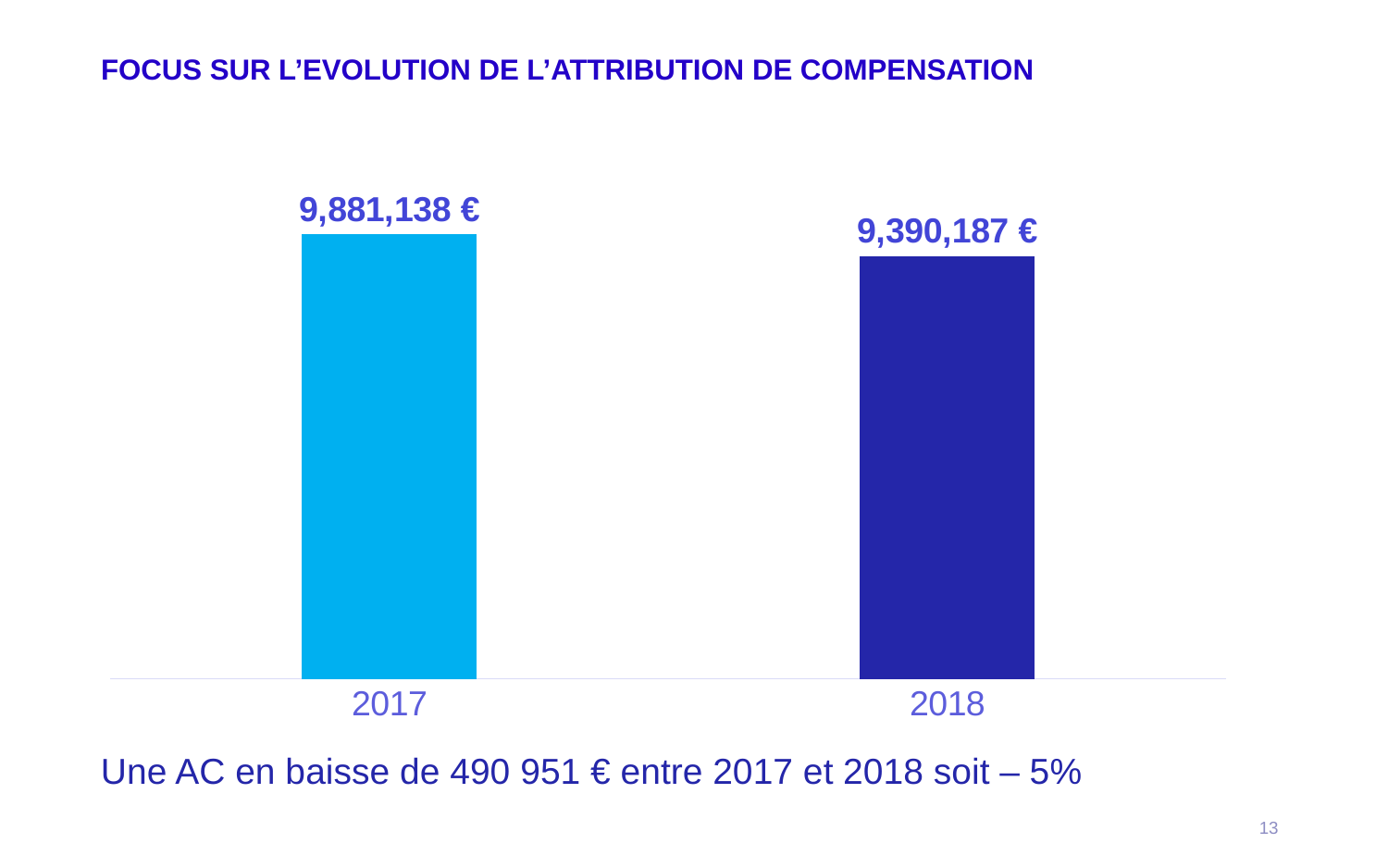
Which year has the lower value? 2018 What colour is the bar for 2017? light blue What is the difference between the 2017 and 2018 values? 490,951 € How many bars are plotted in the chart? 2 Do the values rise or fall from 2017 to 2018? fall What is the value shown for 2018? 9,390,187 € What colour is the bar for 2018? dark blue Which year has the higher value? 2017 What kind of chart is shown on the slide? bar chart What is the value shown for 2017? 9,881,138 € Which years are shown on the x axis? 2017 and 2018 Is the value for 2018 larger or smaller than the value for 2017? smaller